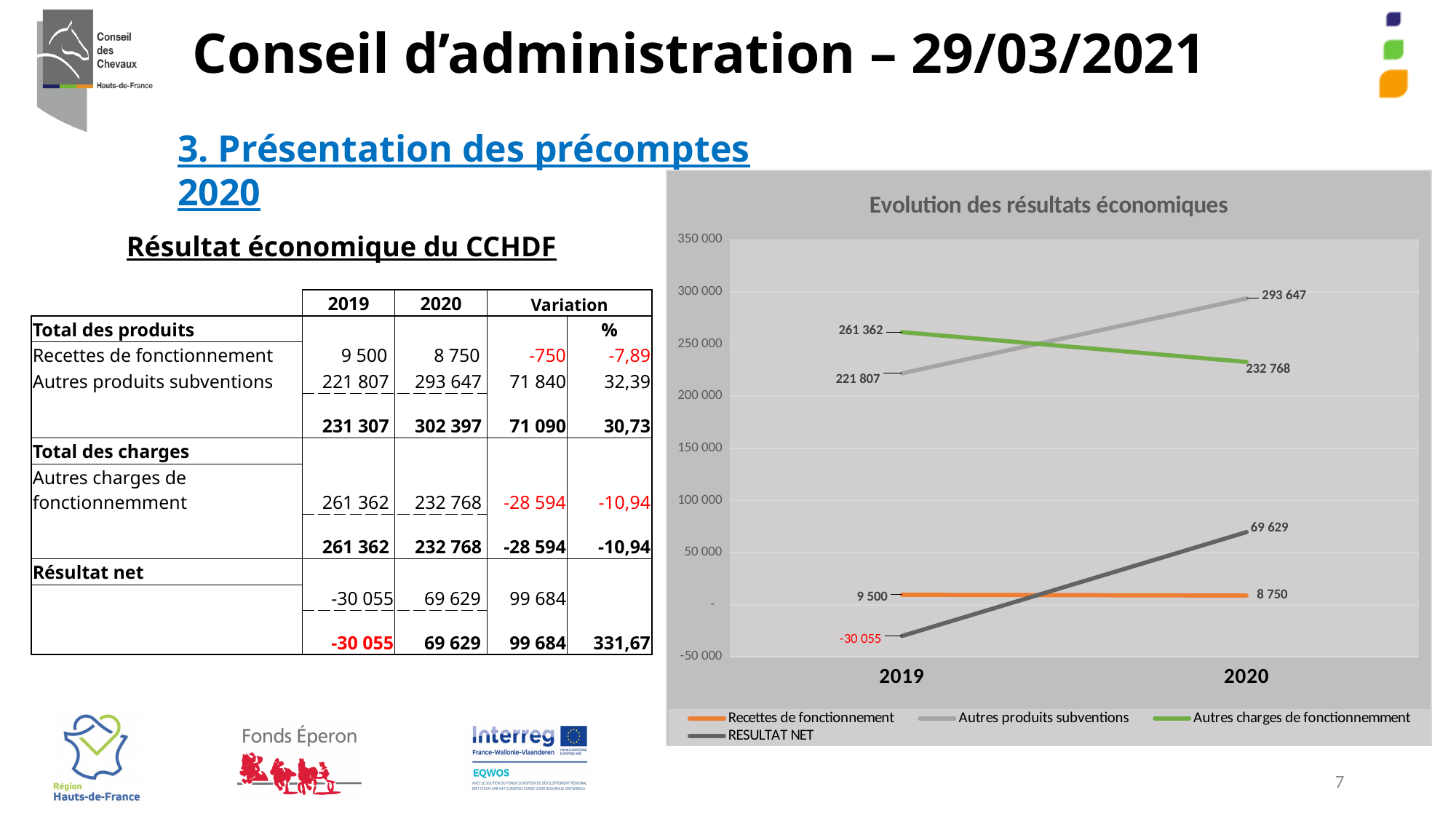
How many years are shown on the x axis of the chart? 2 Which series has the lowest value in 2019? RESULTAT NET What is the value of Autres charges de fonctionnemment in 2019? 261 362 What type of chart is "Evolution des résultats économiques"? line chart What is the value of Recettes de fonctionnement in 2020? 8 750 What is the value of Autres produits subventions in 2020? 293 647 In 2019, which is larger: Autres charges de fonctionnemment or Autres produits subventions? Autres charges de fonctionnemment Which series has the highest value in 2020? Autres produits subventions Does the Autres charges de fonctionnemment line rise or fall from 2019 to 2020? fall How many series does the legend of the chart list? 4 What is the value of RESULTAT NET in 2019? -30 055 What is the difference between the Autres produits subventions values in 2020 and 2019? 71 840